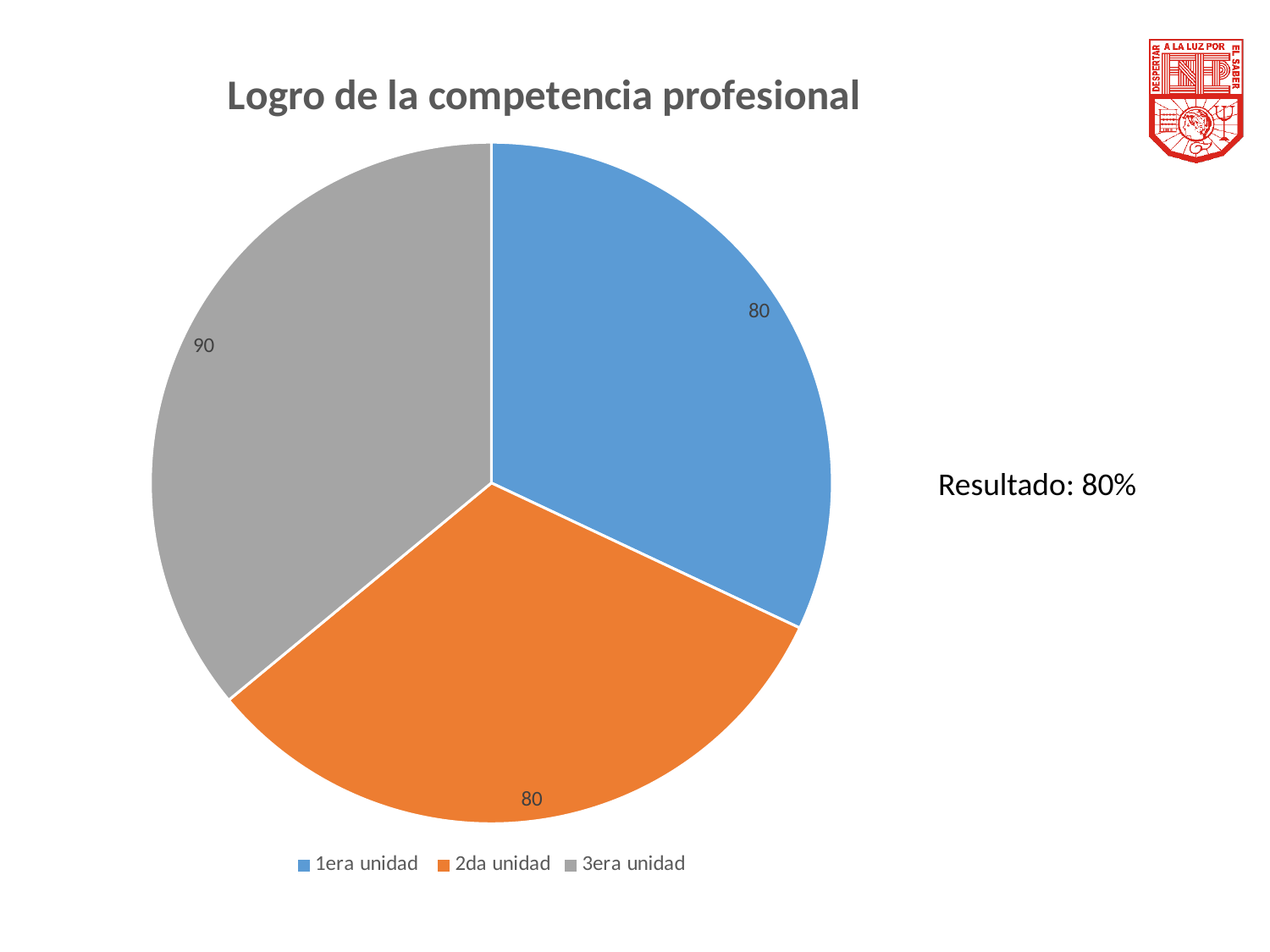
What kind of chart is shown on the slide? Pie chart What is the value shown for 3era unidad? 90 Which is larger, the value for 3era unidad or the value for 2da unidad? 3era unidad What is the value shown for 1era unidad? 80 What is the title of the chart? Logro de la competencia profesional Which colour represents 3era unidad in the pie chart? Gray What is the difference between the values for 3era unidad and 1era unidad? 10 Which unit has the largest slice of the pie? 3era unidad How many entries does the legend list? 3 What is the value shown for 2da unidad? 80 What is the total of all the values in the pie chart? 250 How many slices does the pie chart have? 3